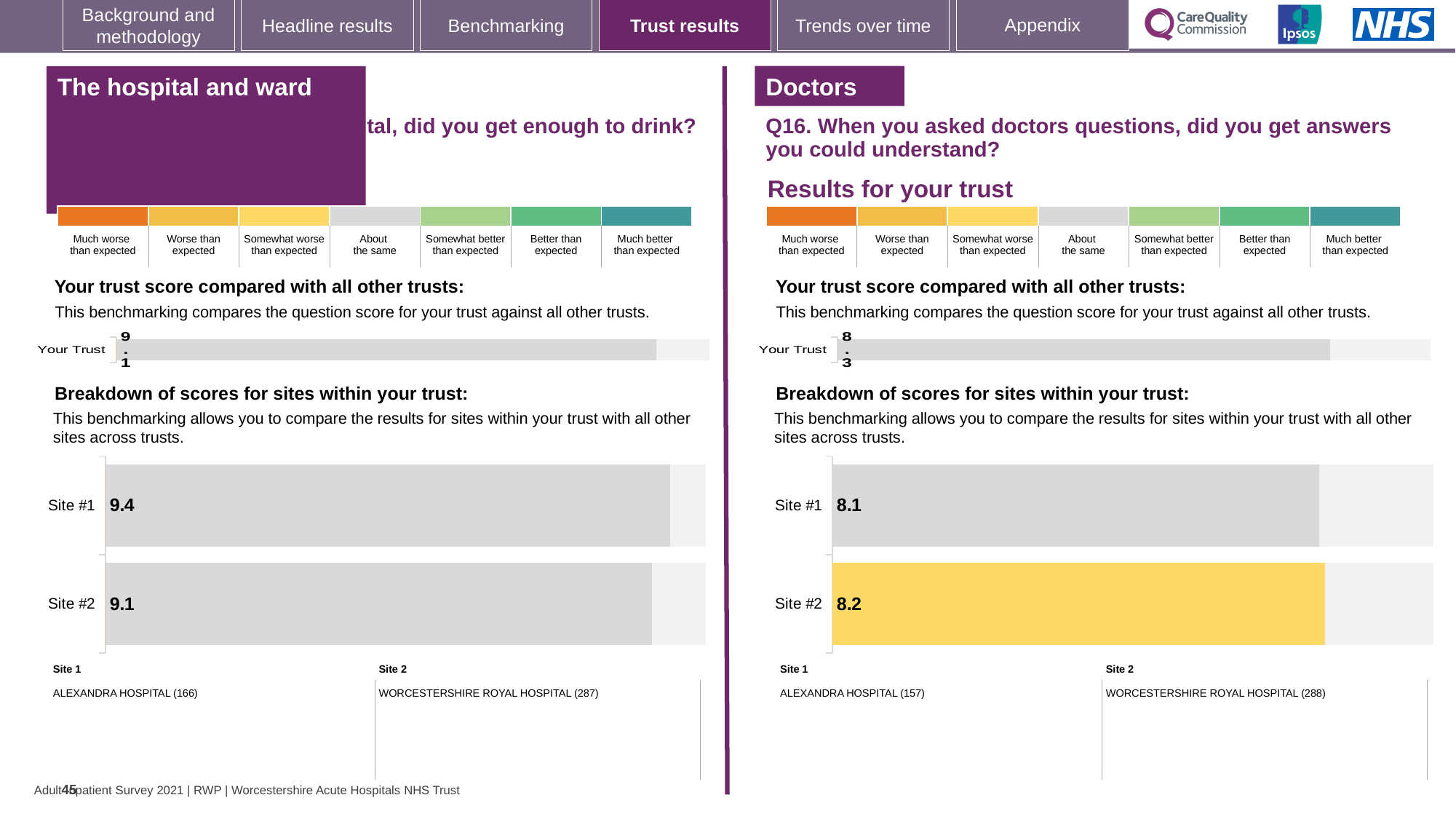
On the left-hand 'Breakdown of scores for sites within your trust' chart, what is the score for Site #1? 9.4 On the right-hand (Q16, Doctors) 'Breakdown of scores for sites within your trust' chart, what is the score for Site #1? 8.1 On the right-hand (Q16, Doctors) site breakdown chart, what is the difference between the Site #2 and Site #1 scores? 0.1 On the right-hand (Q16, Doctors) site breakdown chart, which site has the lower score? Site #1 On the left-hand 'Breakdown of scores for sites within your trust' chart, what is the score for Site #2? 9.1 How many sites are shown on the right-hand (Q16, Doctors) site breakdown chart? 2 On the right-hand (Q16, Doctors) 'Your trust score compared with all other trusts' chart, what is the score shown for Your Trust? 8.3 On the left-hand site breakdown chart, what is the difference between the Site #1 and Site #2 scores? 0.3 On the right-hand (Q16, Doctors) 'Breakdown of scores for sites within your trust' chart, what is the score for Site #2? 8.2 On the left-hand site breakdown chart, which site has the higher score? Site #1 On the left-hand 'Your trust score compared with all other trusts' chart, what is the score shown for Your Trust? 9.1 What type of chart is used for the site breakdown on the left-hand side of the slide? Bar chart